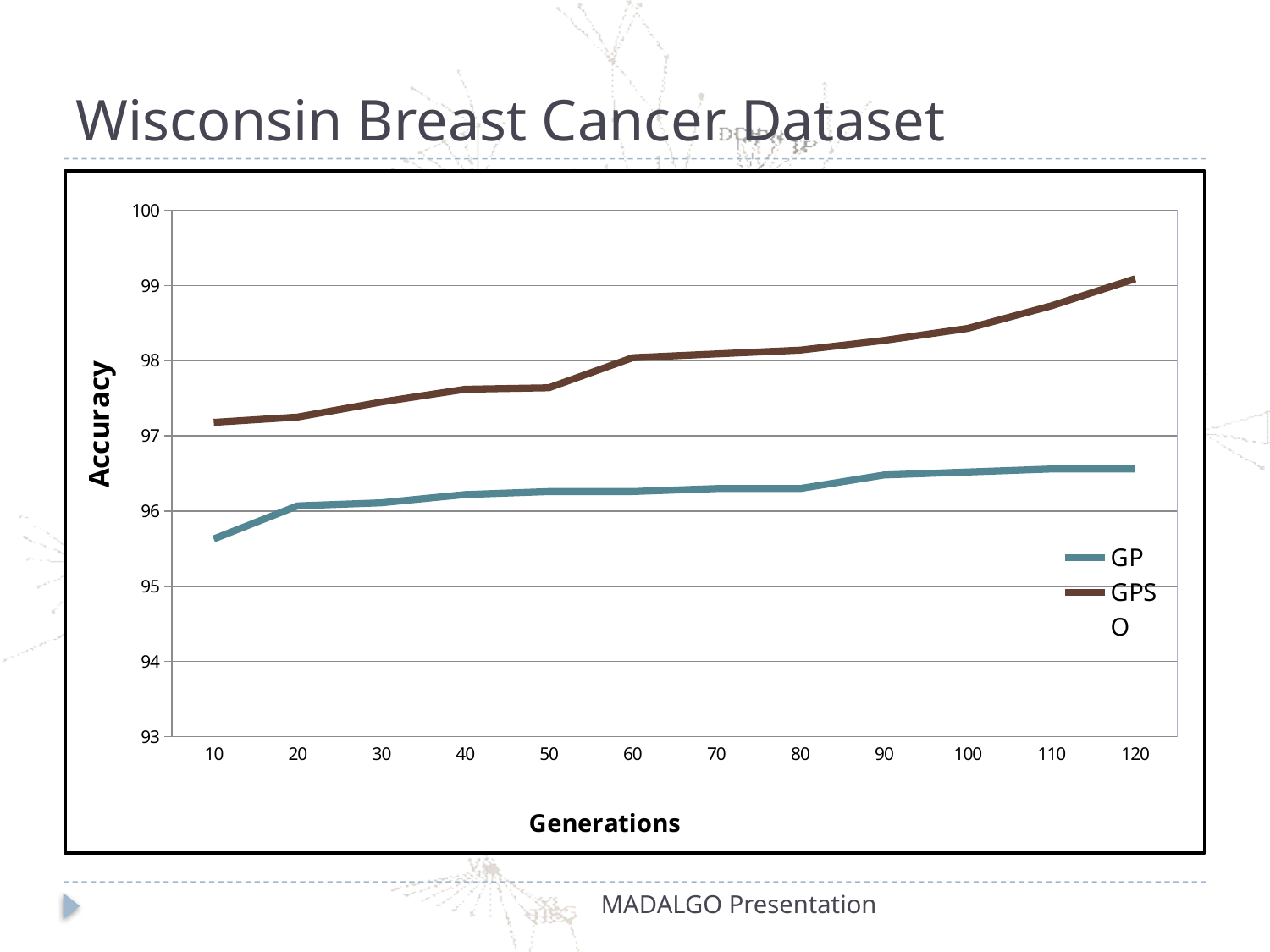
At which generation is the GP accuracy lowest? 10 What is the label of the x axis? Generations What type of chart is shown on the slide? line chart Is the GP accuracy at generation 10 greater or less than 96? less At generation 60, which series has the higher accuracy, GP or GPSO? GPSO Does the GP accuracy rise or fall from generation 10 to generation 120? rise Is the GPSO accuracy at generation 120 greater or less than 98? greater How many series does the legend list? 2 Does the GPSO accuracy rise or fall as generations increase? rise At which generation does GPSO reach its highest accuracy? 120 Is the GP accuracy at generation 90 greater or less than 97? less How many generation values are plotted along the x axis? 12